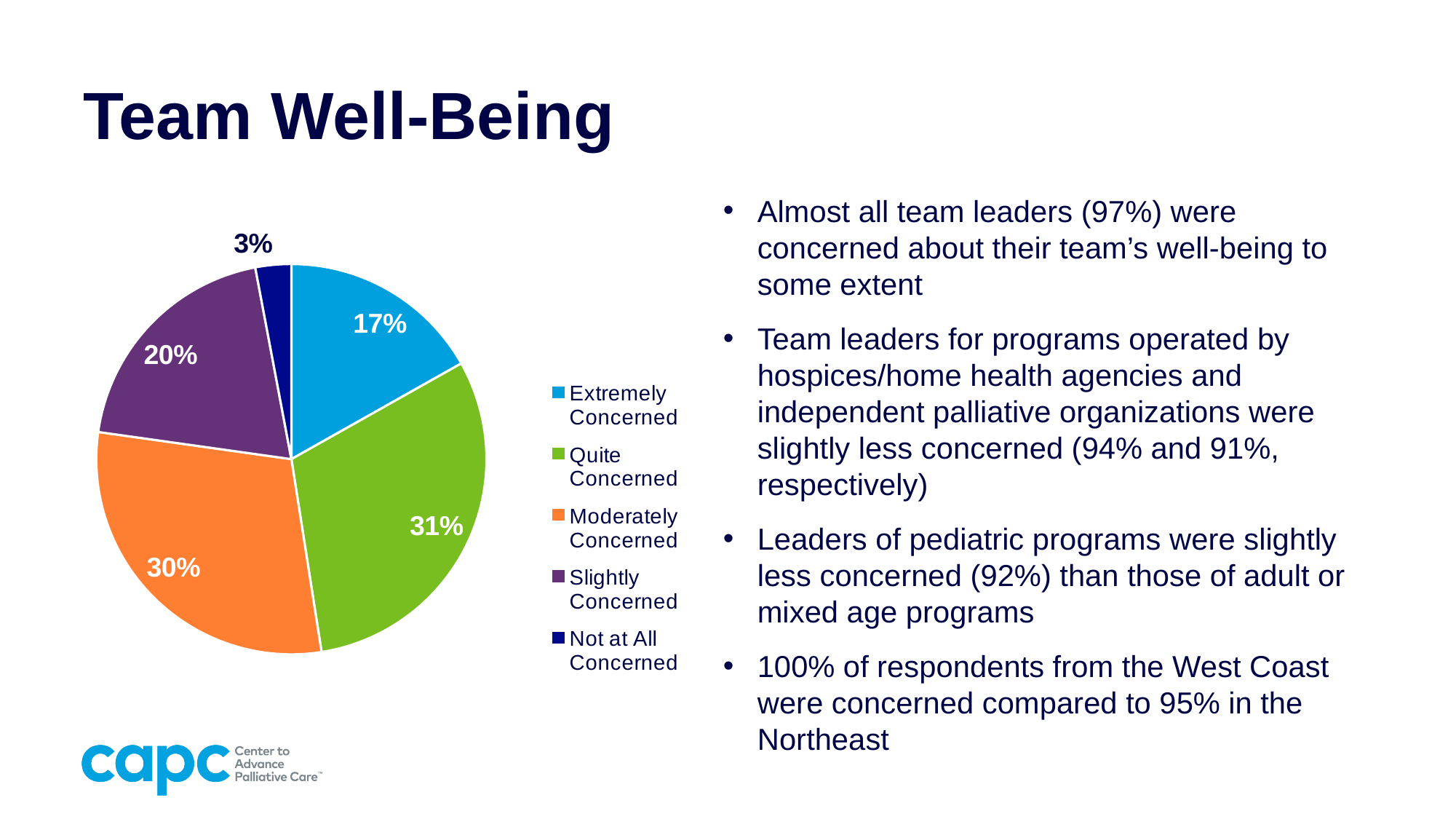
What percentage of team leaders were Slightly Concerned? 20% Which is larger, the Slightly Concerned slice or the Extremely Concerned slice? Slightly Concerned What colour is the Moderately Concerned slice? orange What percentage of team leaders were Not at All Concerned? 3% How many categories does the pie chart show? 5 Which category has the smallest slice of the pie? Not at All Concerned What kind of chart is shown on the slide? pie chart What percentage of team leaders were Moderately Concerned? 30% What percentage of team leaders were Quite Concerned? 31% What is the difference between the Quite Concerned and Extremely Concerned shares? 14% What is the difference between the Slightly Concerned and Not at All Concerned shares? 17% What percentage of team leaders were Extremely Concerned? 17%